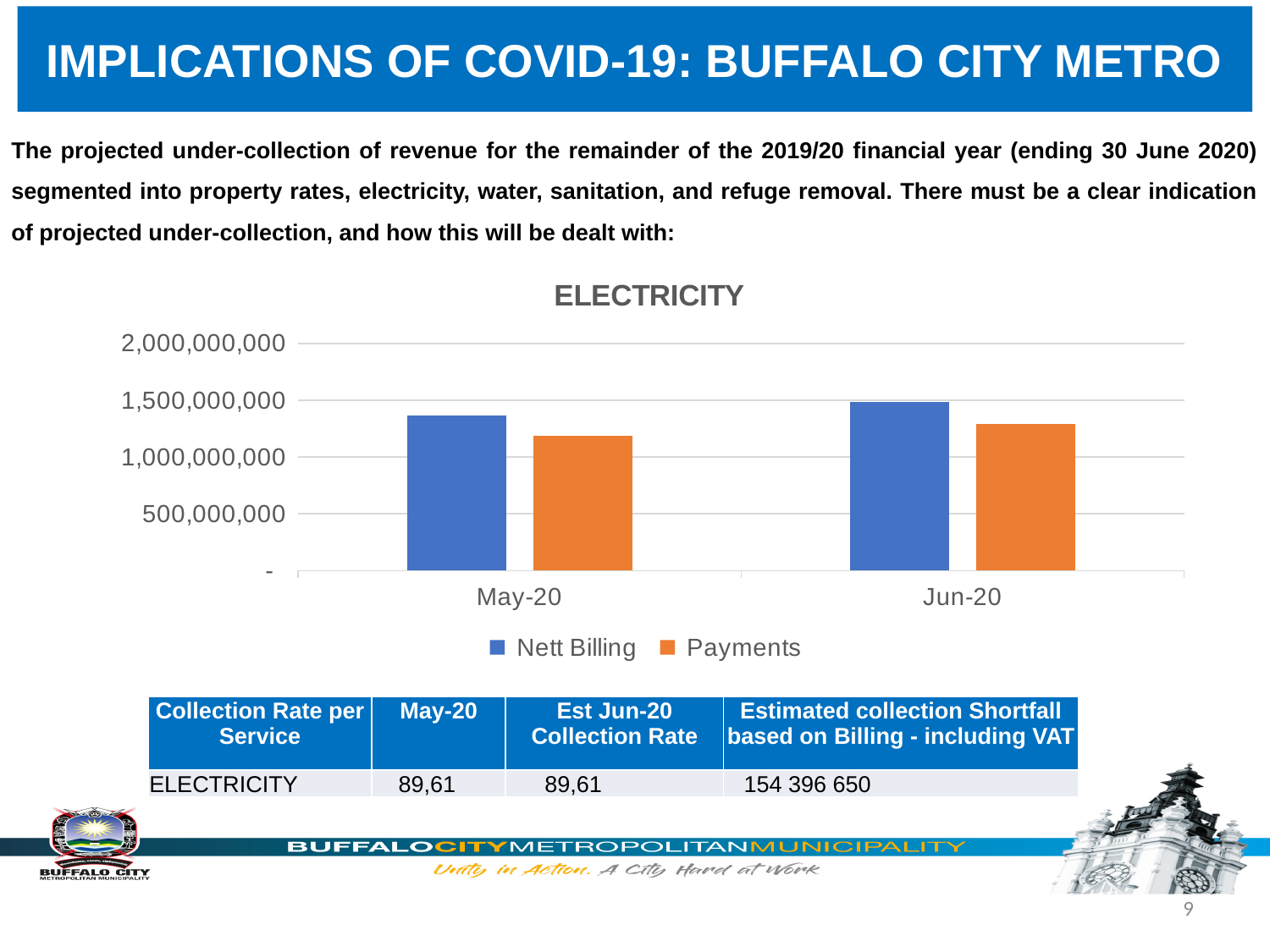
Is the value for Nett Billing in May-20 greater or less than 1,500,000,000? less Is Nett Billing for Jun-20 larger or smaller than Nett Billing for May-20? larger How many categories are shown on the x axis of the chart? 2 What type of chart is shown on the slide? bar chart Do the Payments values rise or fall from May-20 to Jun-20? rise How many series does the chart legend list? 2 What is the title of the chart? ELECTRICITY Which bar is the shortest in the chart? Payments for May-20 Which colour represents Payments in the chart? orange Is the value for Payments in Jun-20 greater or less than 1,000,000,000? greater Which bar is the tallest in the chart? Nett Billing for Jun-20 In May-20, which is larger: Nett Billing or Payments? Nett Billing